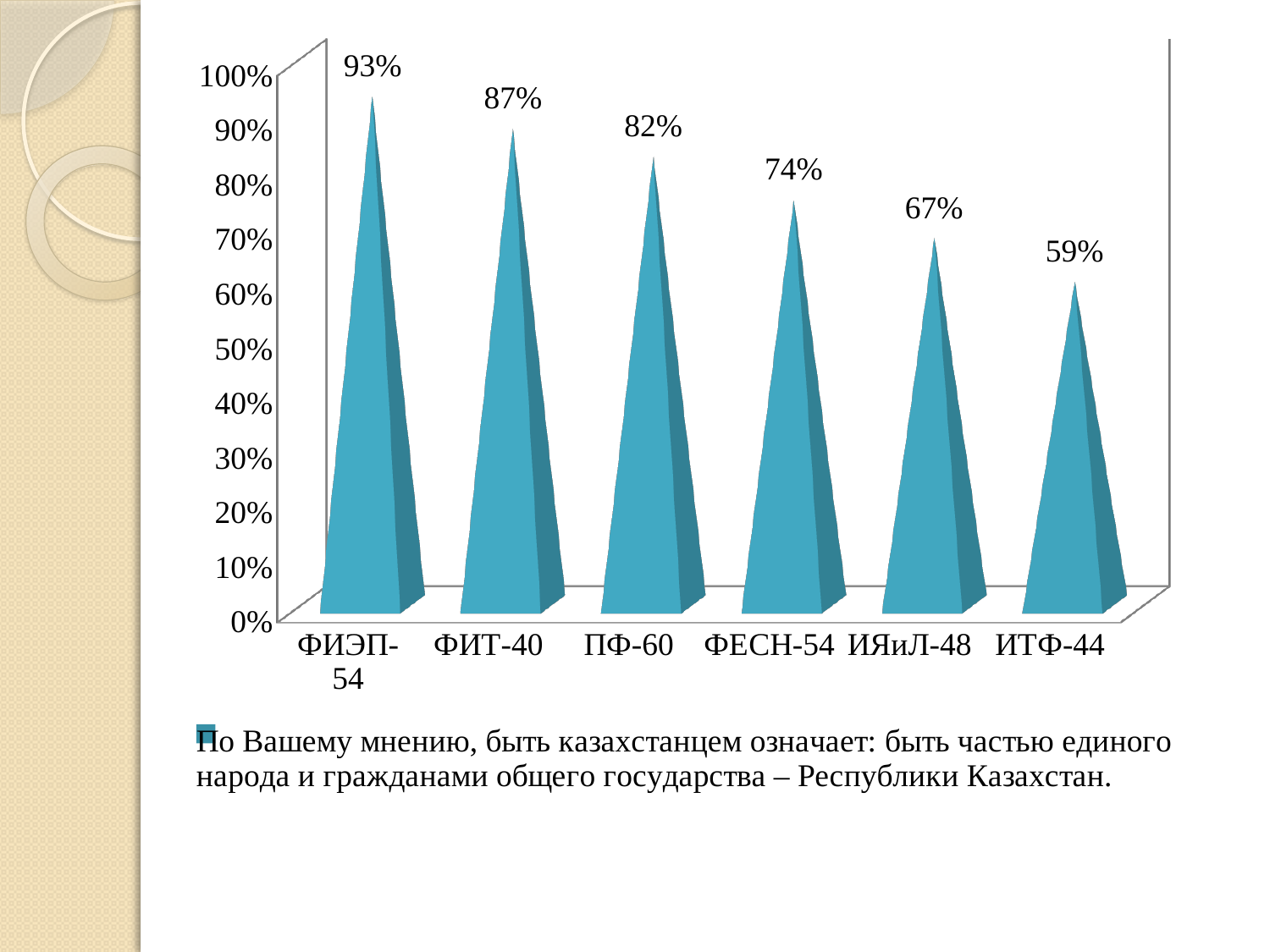
What is the difference between the values for ФИТ-40 and ФЕСН-54? 13% What is the value for ИЯиЛ-48? 67% Do the values rise or fall from left to right along the x axis? fall What is the difference between the values for ФИЭП-54 and ИТФ-44? 34% Which is larger, the value for ПФ-60 or the value for ИЯиЛ-48? ПФ-60 Which category has the highest value? ФИЭП-54 Which category has the lowest value? ИТФ-44 What is the value for ФИЭП-54? 93% What kind of chart is this? bar chart What is the value for ПФ-60? 82% How many series does the legend list? 1 How many categories are shown on the x axis? 6